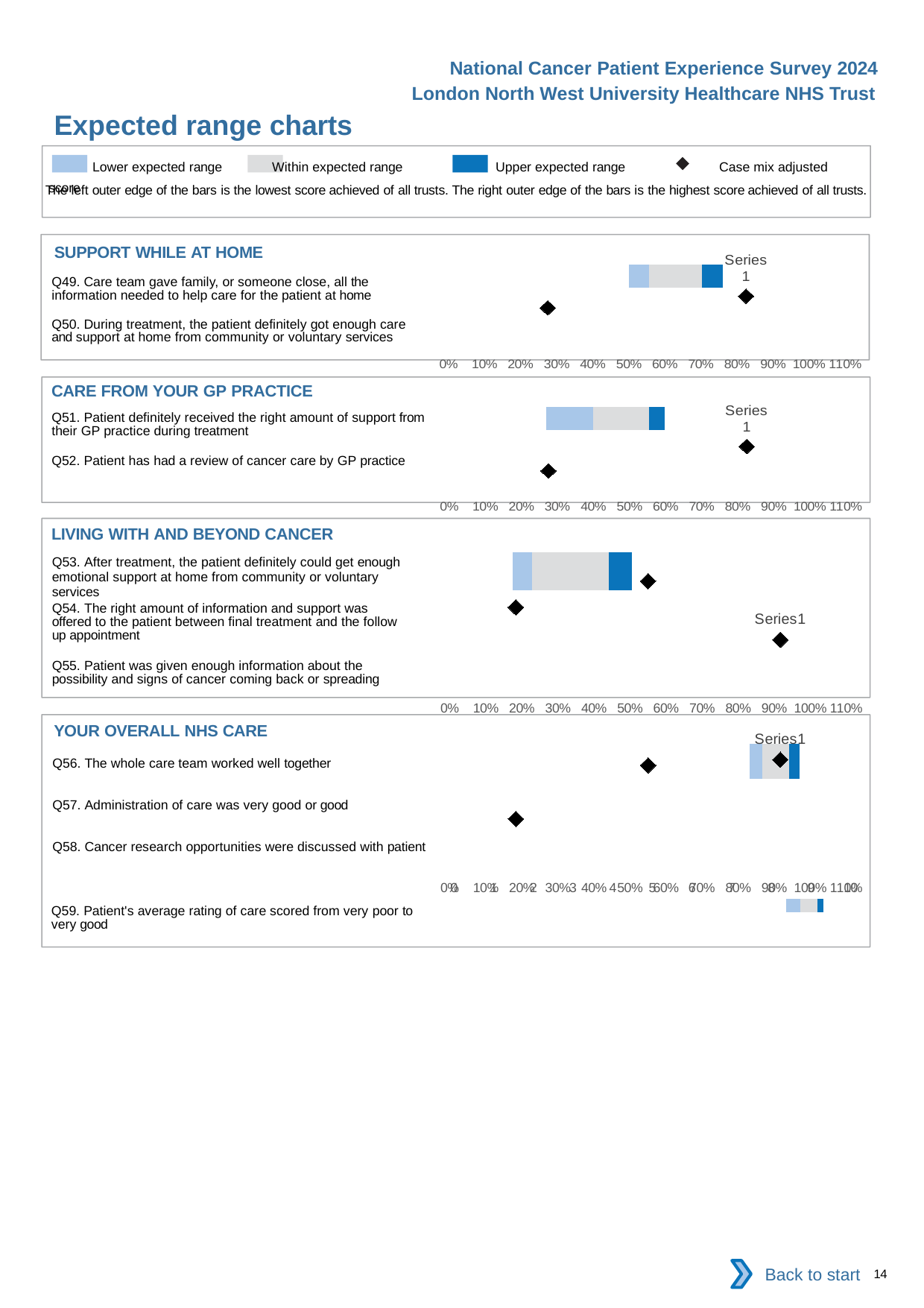
How many questions are listed in the SUPPORT WHILE AT HOME section? 2 How many entries does the legend at the top of the slide list? 4 In the CARE FROM YOUR GP PRACTICE chart, is the right edge of the expected range bar greater or less than 50%? greater In the LIVING WITH AND BEYOND CANCER chart, is the left edge of the expected range bar greater or less than 10%? greater How many chart sections are shown on the slide? 4 How many questions are listed in the YOUR OVERALL NHS CARE section? 4 What is the highest tick label shown on the x axis of the CARE FROM YOUR GP PRACTICE chart? 110% What is the title of the slide? Expected range charts In the CARE FROM YOUR GP PRACTICE chart, is the left edge of the expected range bar greater or less than 20%? greater What kind of chart is used in the SUPPORT WHILE AT HOME section? Bar chart